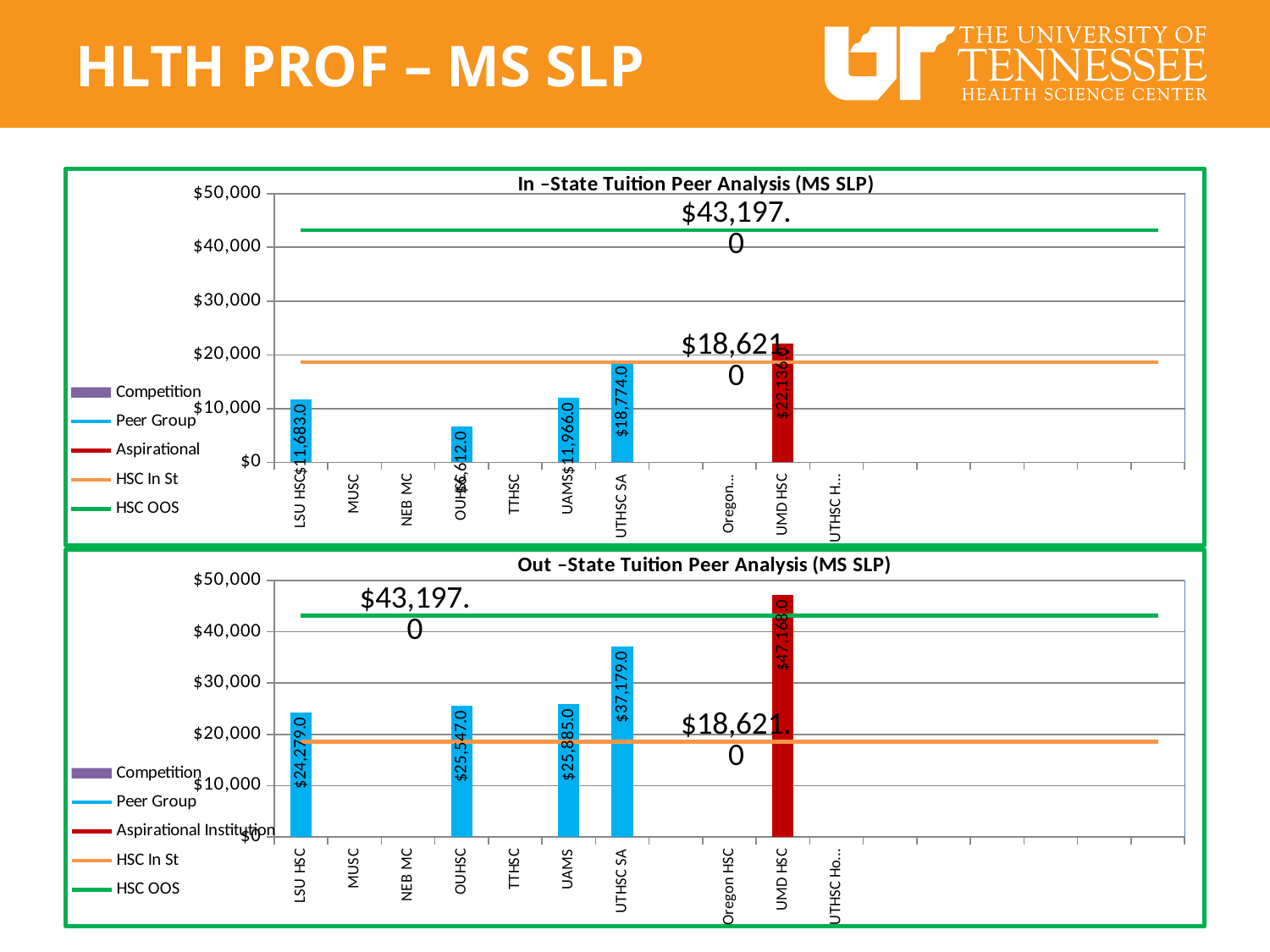
In the Out-State Tuition Peer Analysis chart, what is the value for UMD HSC? $47,168.0 In the Out-State Tuition Peer Analysis chart, is the value for UTHSC SA greater or less than $30,000? greater In the In-State Tuition Peer Analysis chart, which institution has the lowest bar? OUHSC In the In-State Tuition Peer Analysis chart, what is the value for UTHSC SA? $18,774.0 In the In-State Tuition Peer Analysis chart, what value is shown for the HSC OOS line? $43,197.0 In the Out-State Tuition Peer Analysis chart, what is the value for LSU HSC? $24,279.0 In the In-State Tuition Peer Analysis chart, what is the value for OUHSC? $6,612.0 How many entries does the legend of the Out-State Tuition Peer Analysis chart list? 5 In the Out-State Tuition Peer Analysis chart, which is larger, the bar for UAMS or the bar for LSU HSC? UAMS In the In-State Tuition Peer Analysis chart, what is the difference between the UMD HSC bar and the UTHSC SA bar? $3,362.0 What kind of chart is the In-State Tuition Peer Analysis chart? Bar chart In the In-State Tuition Peer Analysis chart, which institution has the highest bar? UMD HSC